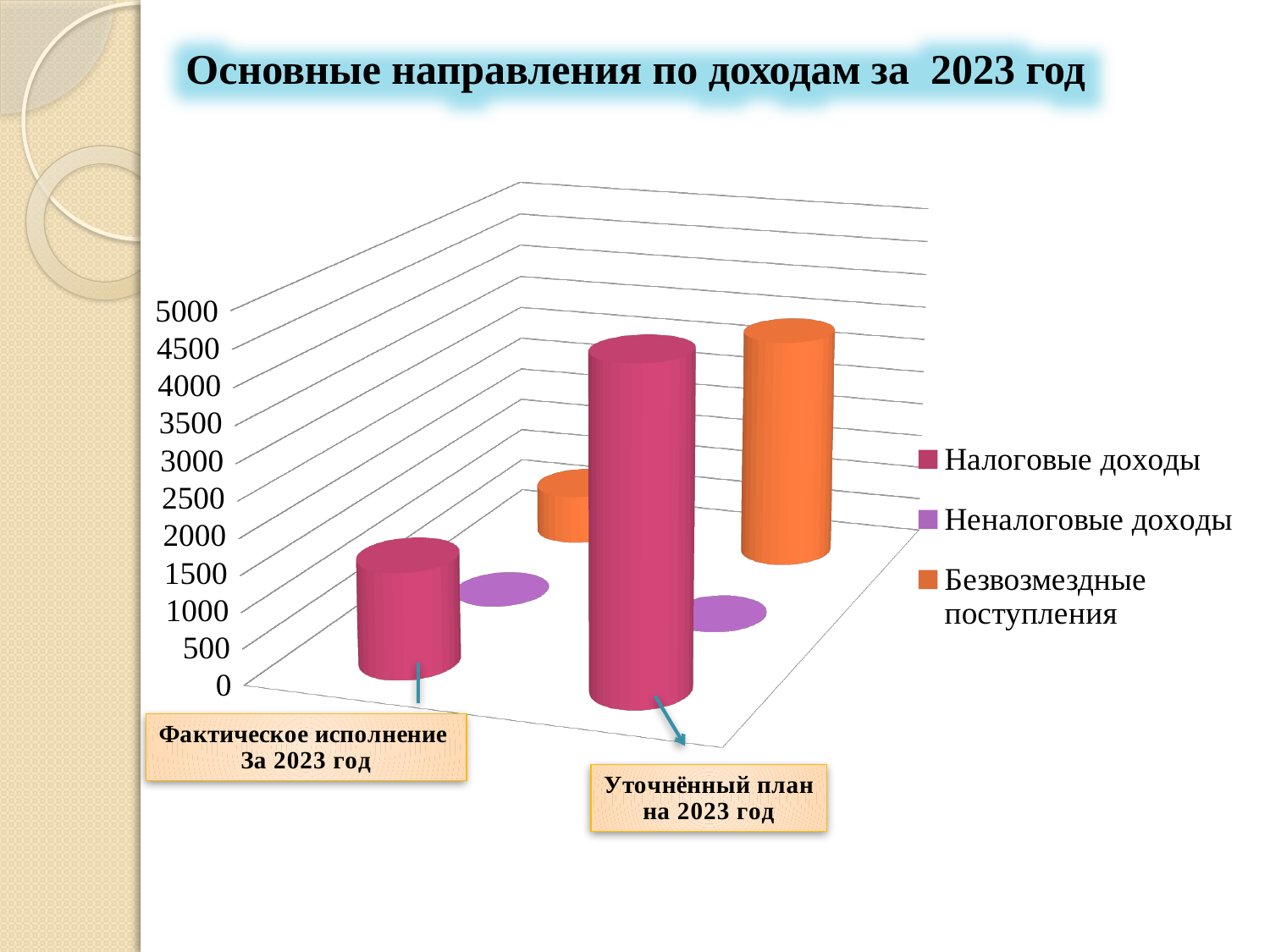
How many categories are shown on the x axis of the chart? 2 Is the value for Налоговые доходы in Уточнённый план на 2023 год greater or less than 2500? greater Is the value for Налоговые доходы in Фактическое исполнение За 2023 год greater or less than 2500? less In Уточнённый план на 2023 год, which is larger: Налоговые доходы or Неналоговые доходы? Налоговые доходы Is the value for Безвозмездные поступления in Уточнённый план на 2023 год greater or less than 2500? greater How many series does the legend list? 3 Which is larger for Налоговые доходы: Фактическое исполнение За 2023 год or Уточнённый план на 2023 год? Уточнённый план на 2023 год Which series is shown in orange in the legend? Безвозмездные поступления Which is larger for Безвозмездные поступления: Фактическое исполнение За 2023 год or Уточнённый план на 2023 год? Уточнённый план на 2023 год What kind of chart is shown on the slide? bar chart